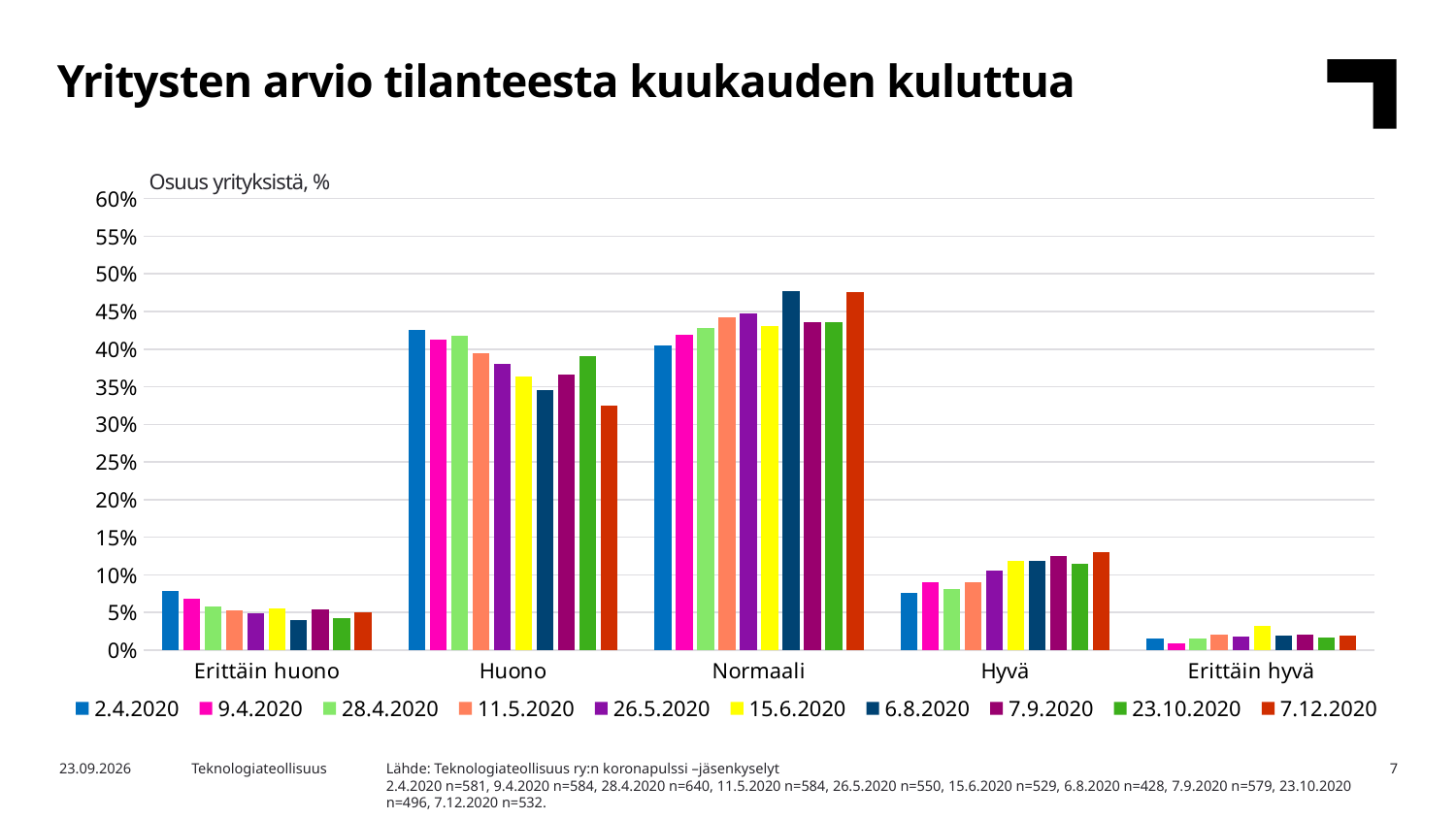
For the Hyvä category, do the values generally rise or fall from the 2.4.2020 series to the 7.12.2020 series? rise What is the title of the chart on the slide? Yritysten arvio tilanteesta kuukauden kuluttua Is the value for Hyvä in the 7.12.2020 series greater or less than 10%? greater Is the value for Normaali in the 7.12.2020 series greater or less than 45%? greater How many categories are shown on the x axis of the chart? 5 Which category has the highest value in the 6.8.2020 series? Normaali How many series does the chart's legend list? 10 Which category has the lowest value in the 2.4.2020 series? Erittäin hyvä Is the value for Huono in the 2.4.2020 series greater or less than 40%? greater In the 7.12.2020 series, which is larger: Huono or Normaali? Normaali What kind of chart is shown on the slide? bar chart